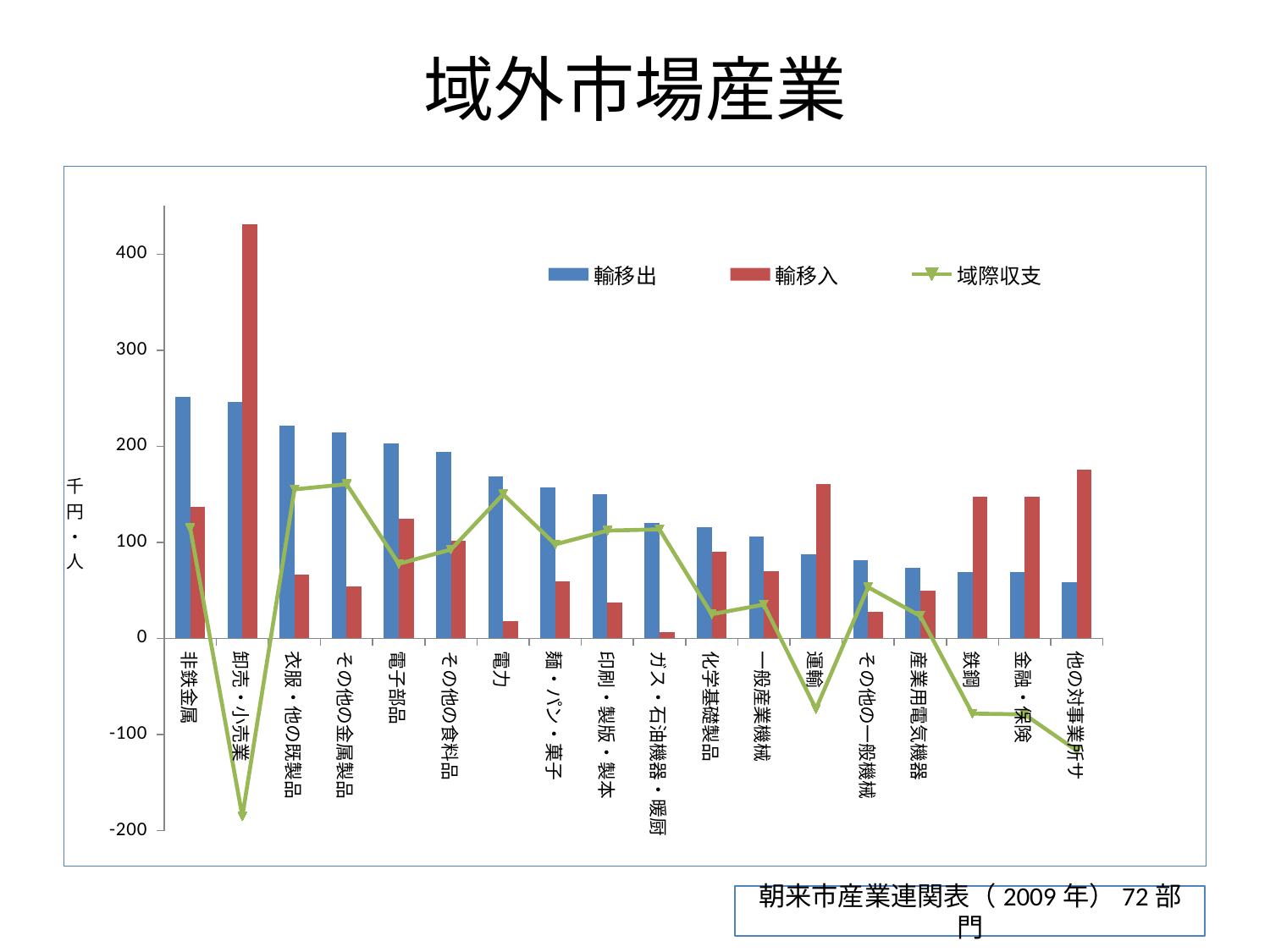
Do the 輸移出 values generally rise or fall from left to right along the x axis? fall Is the 域際収支 value for 運輸 greater or less than 0? less How many categories are shown on the x axis? 18 What kind of chart is shown on the slide? A bar chart combined with a line chart Which category has the highest 輸移入 value? 卸売・小売業 How many series does the legend list? 3 For 鉄鋼, which is larger, 輸移出 or 輸移入? 輸移入 What is the label on the vertical axis? 千円・人 Is the 輸移入 value for 電力 greater or less than 100? less Which category has the lowest 輸移入 value? ガス・石油機器・暖厨 Is the 輸移入 value for 卸売・小売業 greater or less than 400? greater Which category has the lowest 域際収支 value? 卸売・小売業